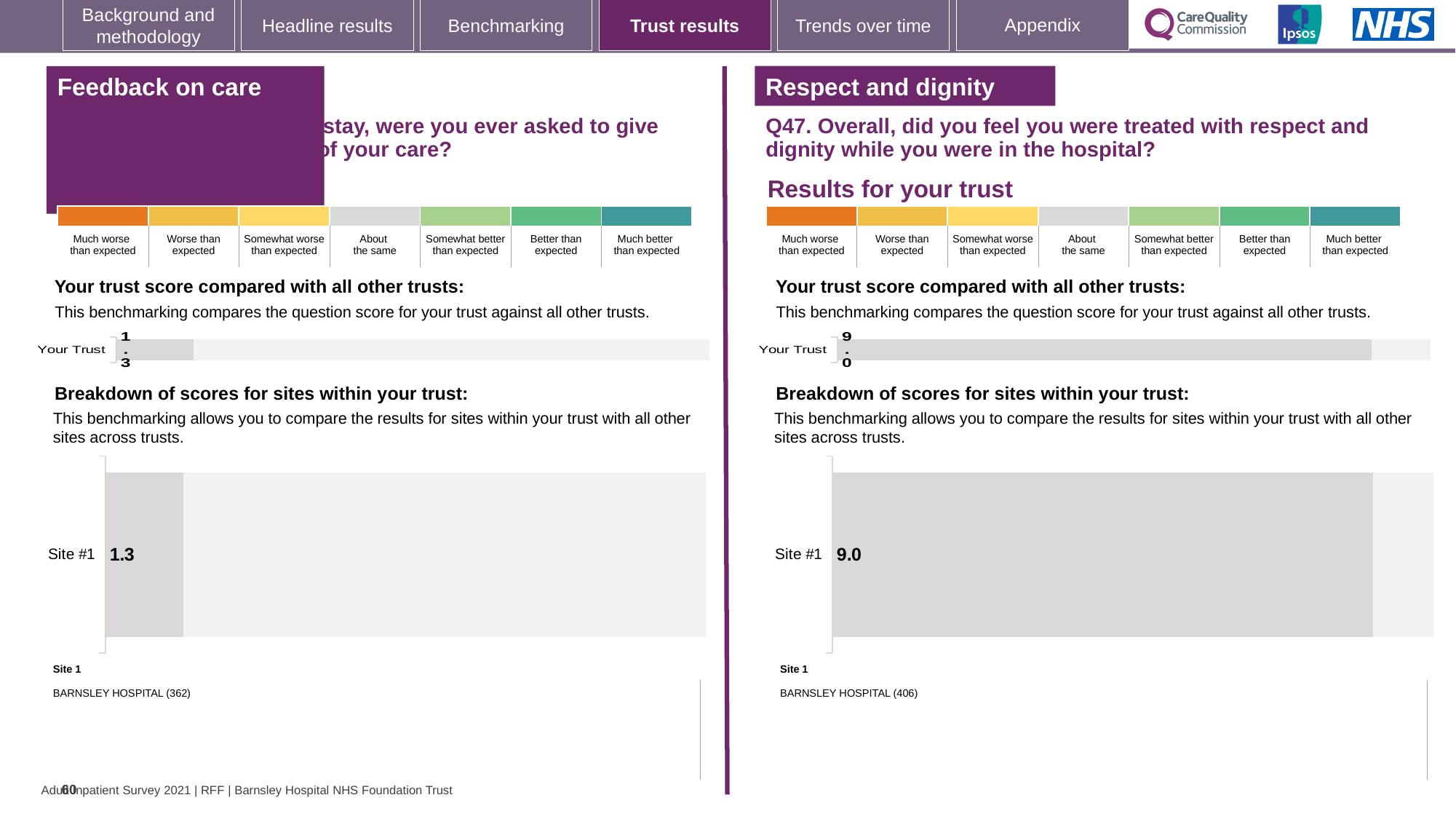
What is the difference between the Site #1 score in the 'Respect and dignity' section and the Site #1 score in the 'Feedback on care' section? 7.7 Is the Site #1 score in the 'Respect and dignity' section greater or less than 5? greater How many sites are shown in the breakdown of scores chart in the 'Respect and dignity' section? 1 How many sites are shown in the breakdown of scores chart in the 'Feedback on care' section? 1 On the left-hand 'Feedback on care' section, what value is shown for 'Your Trust' in the trust score chart? 1.3 What type of chart is used to show the Site #1 score in the 'Feedback on care' breakdown of scores? Bar chart On the right-hand 'Respect and dignity' section, what is the score shown for Site #1 in the breakdown of scores chart? 9.0 On the right-hand 'Respect and dignity' section, what value is shown for 'Your Trust' in the trust score chart? 9.0 Which section's Site #1 score is larger: 'Feedback on care' or 'Respect and dignity'? Respect and dignity Which hospital is listed as Site 1 in the 'Respect and dignity' section? BARNSLEY HOSPITAL (406) On the left-hand 'Feedback on care' section, what is the score shown for Site #1 in the breakdown of scores chart? 1.3 Which hospital is listed as Site 1 in the 'Feedback on care' section? BARNSLEY HOSPITAL (362)